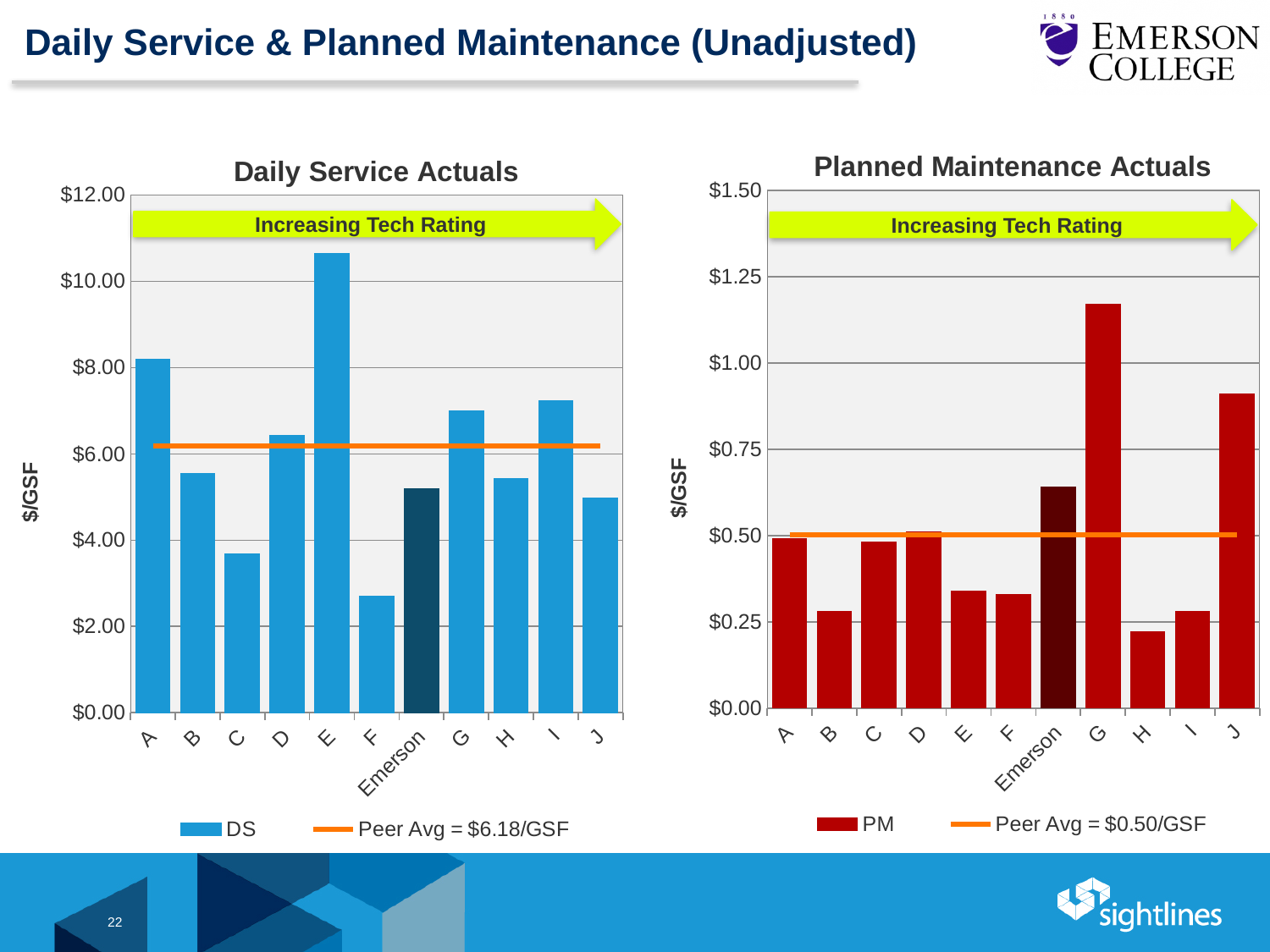
How many categories are shown on the x axis of the Daily Service Actuals chart? 11 In the Planned Maintenance Actuals chart, is the value for Emerson greater or less than $0.50? greater In the Daily Service Actuals chart, is the value for Emerson greater or less than $6.00? less What peer average value is stated in the legend of the Planned Maintenance Actuals chart? $0.50/GSF What type of chart is the Daily Service Actuals chart? bar chart In the Planned Maintenance Actuals chart, which category has the lowest value? H In the Daily Service Actuals chart, is the value for E greater or less than $10.00? greater In the Planned Maintenance Actuals chart, which is larger, the value for G or the value for J? G In the Planned Maintenance Actuals chart, which category has the highest value? G In the Daily Service Actuals chart, which category has the lowest value? F What peer average value is stated in the legend of the Daily Service Actuals chart? $6.18/GSF In the Daily Service Actuals chart, which category has the highest value? E